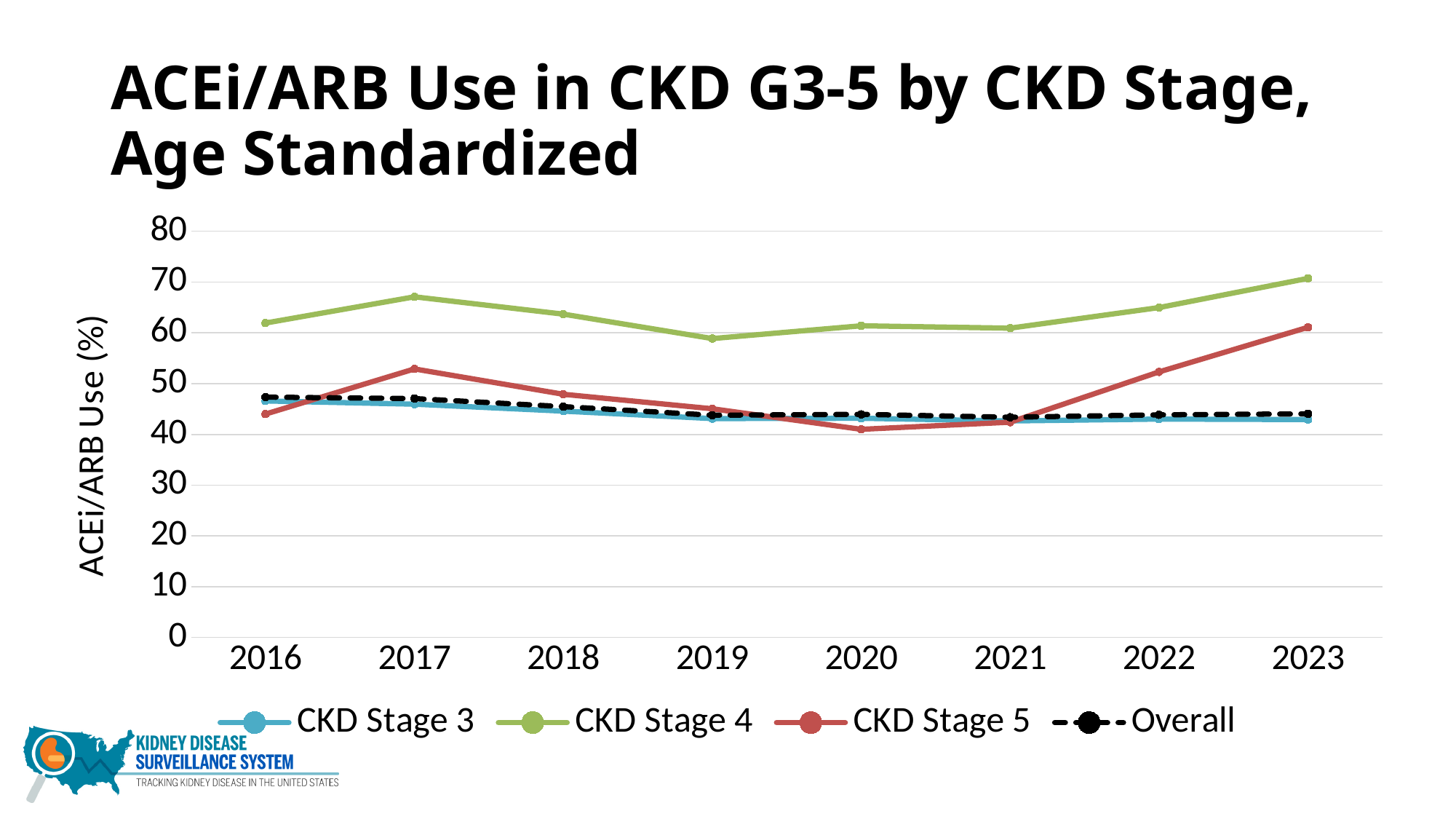
Which series has the highest value in 2023? CKD Stage 4 Is the value for CKD Stage 5 in 2020 greater or less than 50? less In which year is CKD Stage 5 at its highest? 2023 Which series is drawn with a dashed line? Overall How many series does the legend list? 4 In which year is CKD Stage 4 at its lowest? 2019 In 2017, which is larger: CKD Stage 5 or CKD Stage 3? CKD Stage 5 Does the CKD Stage 5 line rise or fall from 2021 to 2023? Rises How many years are plotted along the x axis? 8 Is the value for CKD Stage 4 in 2017 greater or less than 60? greater What kind of chart is shown on the slide? Line chart Is the value for Overall in 2016 greater or less than 40? greater